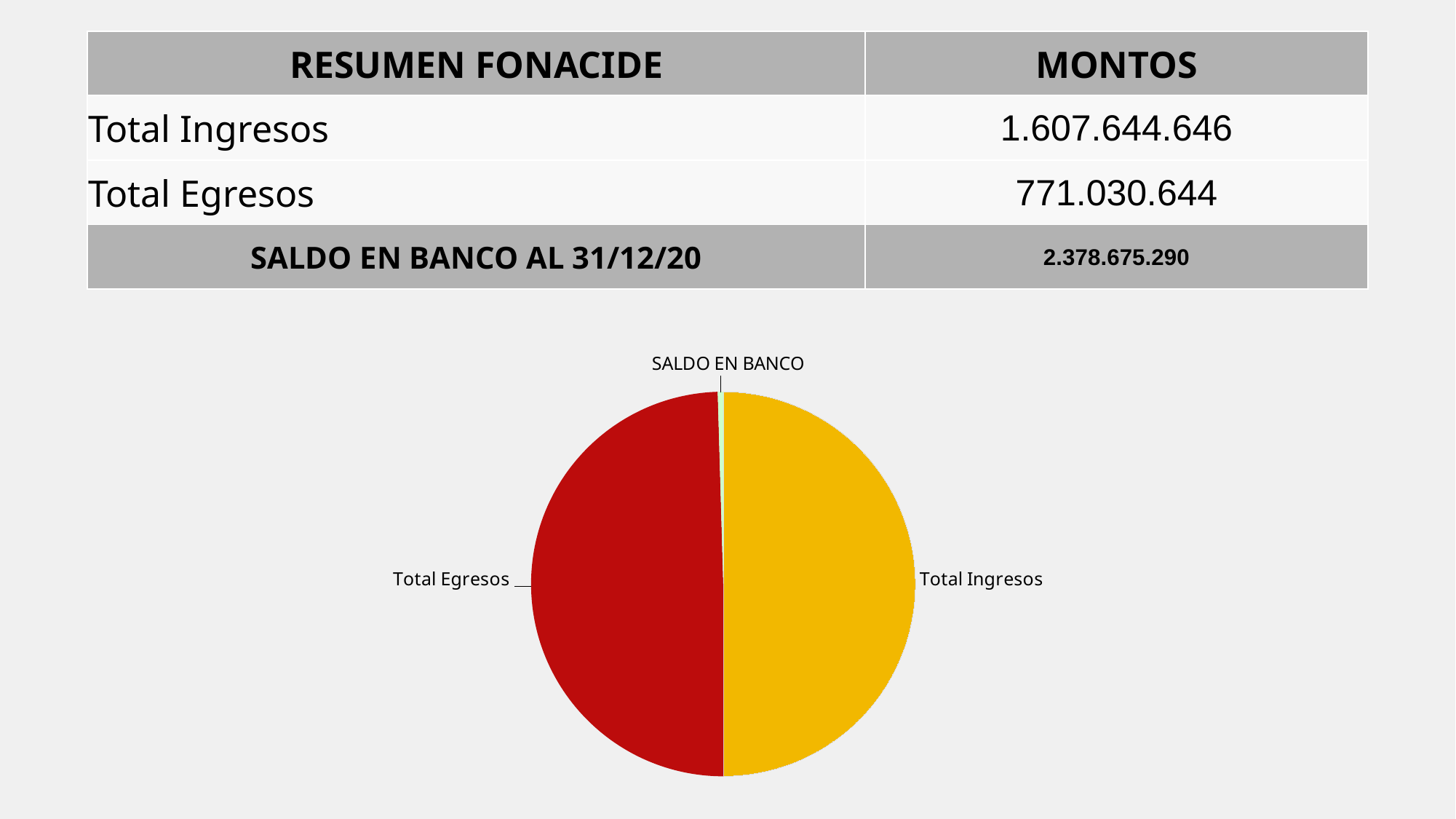
What is the label of the slice at the top of the pie chart? SALDO EN BANCO Which slice of the pie chart is the smallest? SALDO EN BANCO In the pie chart, which is larger: the Total Ingresos slice or the SALDO EN BANCO slice? Total Ingresos In the pie chart, which is larger: the Total Egresos slice or the SALDO EN BANCO slice? Total Egresos What colour is the Total Egresos slice in the pie chart? red Which slice of the pie chart is coloured yellow? Total Ingresos How many slices does the pie chart have? 3 What kind of chart is shown on the slide? pie chart